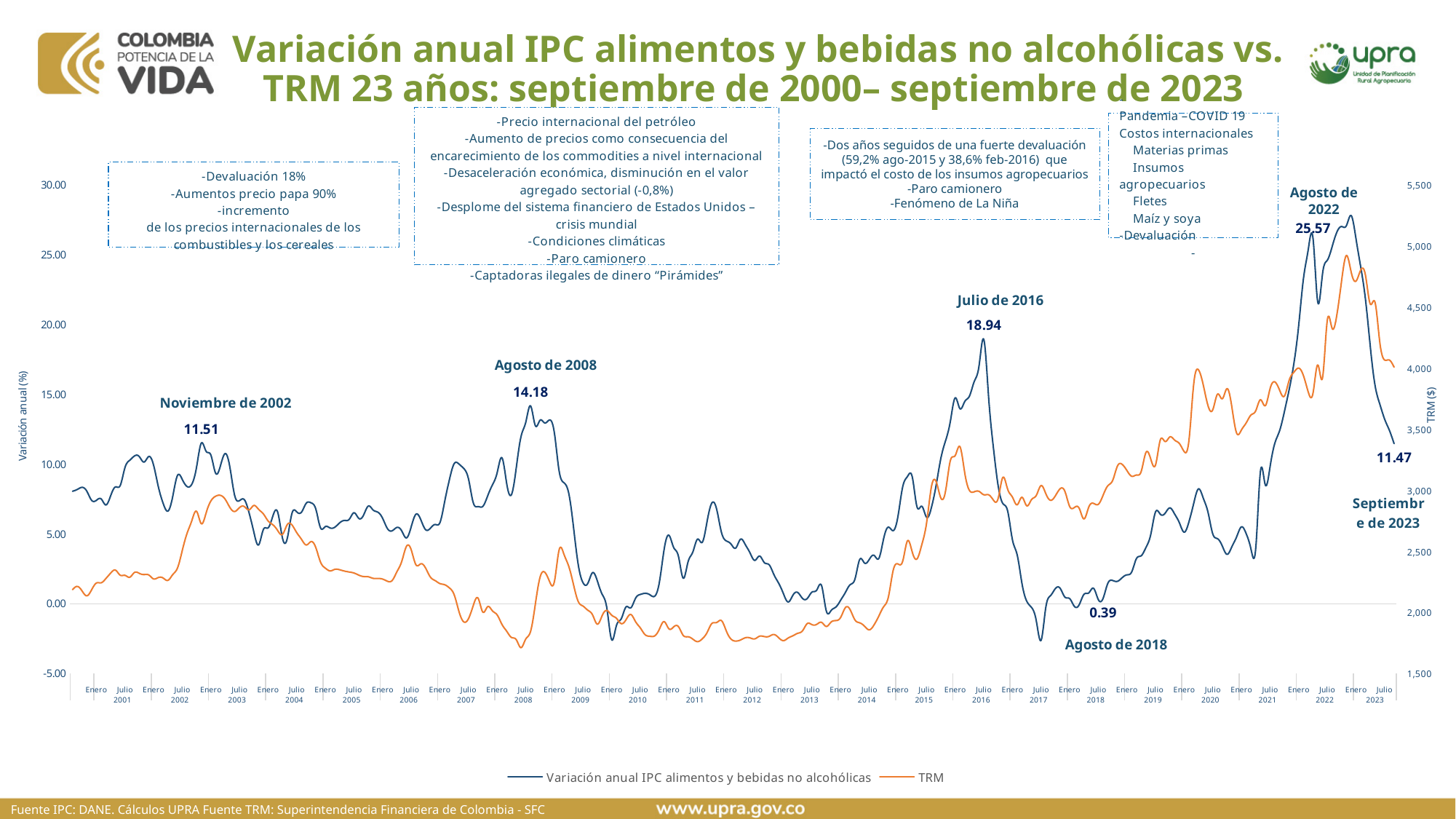
What is the label of the right-hand vertical axis? TRM ($) What is the labelled value of the Variación anual IPC series in Julio de 2016? 18.94 Is the TRM value at Enero 2001 greater or less than 2,500? less Which labelled value is larger: Agosto de 2008 or Noviembre de 2002? Agosto de 2008 What kind of chart is shown on the slide? Line chart What is the difference between the labelled values for Agosto de 2022 and Julio de 2016? 6.63 What is the labelled value of the Variación anual IPC series in Agosto de 2022? 25.57 What is the labelled value of the Variación anual IPC series in Noviembre de 2002? 11.51 Which labelled point of the Variación anual IPC series has the highest value? Agosto de 2022 What is the labelled value of the Variación anual IPC series in Agosto de 2018? 0.39 What is the labelled value of the Variación anual IPC series in Septiembre de 2023? 11.47 How many series does the legend list? 2